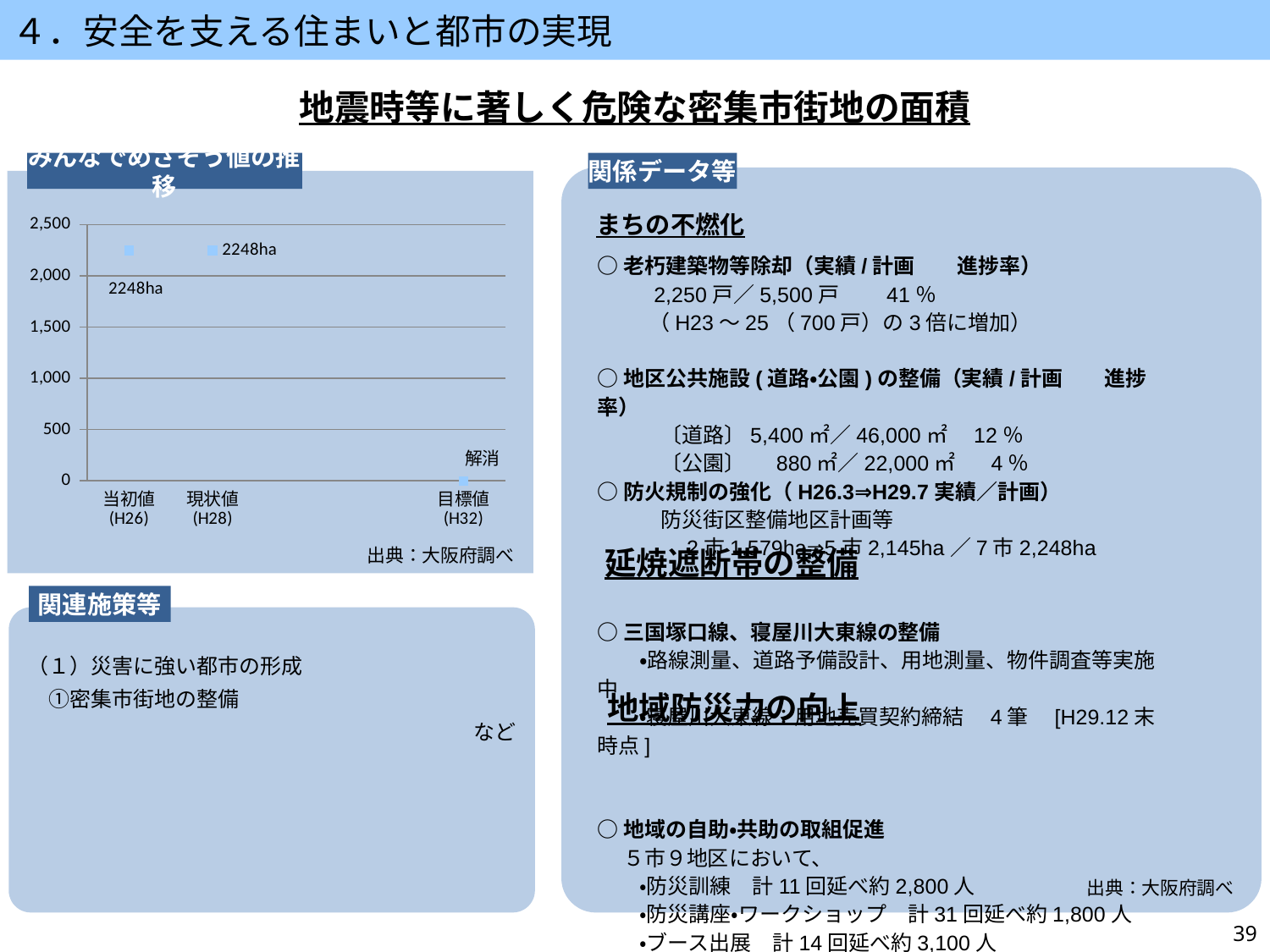
Which category has the lowest value in the chart? 目標値 (H32) What label is shown for the 目標値 (H32) point in the chart? 解消 How many data points are plotted in the chart? 3 Is the value for 当初値 (H26) larger than, smaller than, or the same as the value for 現状値 (H28)? the same What is the difference between the values for 当初値 (H26) and 現状値 (H28)? 0 What source is cited below the chart? 出典：大阪府調べ Is the value for 目標値 (H32) greater or less than 500? less Do the values rise or fall from 当初値 (H26) to 目標値 (H32)? fall What is the value for 現状値 (H28) in the chart? 2248ha Is the value for 当初値 (H26) greater or less than 2,000? greater What is the value for 当初値 (H26) in the chart? 2248ha What is the title of the chart? みんなでめざそう値の推移